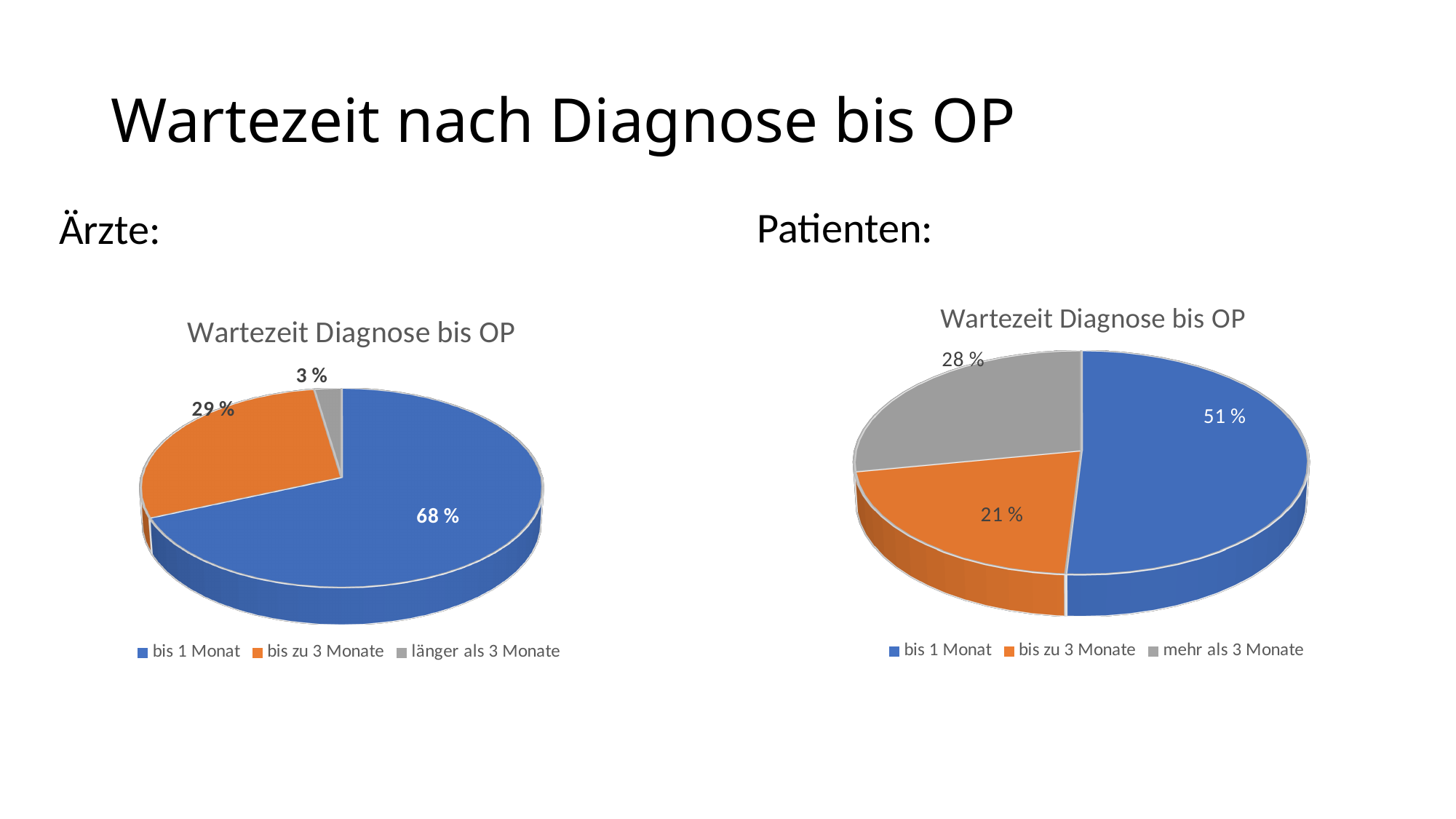
In the Ärzte pie chart on the left, what is the value for 'bis zu 3 Monate'? 29 % In the Patienten pie chart on the right, which category has the smallest share? bis zu 3 Monate Which chart shows a larger value for 'bis 1 Monat', the Ärzte chart on the left or the Patienten chart on the right? Ärzte chart on the left In the Ärzte pie chart on the left, what is the value for 'bis 1 Monat'? 68 % In the Patienten pie chart on the right, what is the value for 'mehr als 3 Monate'? 28 % In the Ärzte pie chart on the left, which category has the largest share? bis 1 Monat What kind of chart is the Ärzte chart on the left? Pie chart In the Patienten pie chart on the right, what is the value for 'bis 1 Monat'? 51 % In the Ärzte pie chart on the left, what is the value for 'länger als 3 Monate'? 3 % In the Patienten pie chart on the right, what is the difference between 'mehr als 3 Monate' and 'bis zu 3 Monate'? 7 % In the Ärzte pie chart on the left, what is the difference between 'bis 1 Monat' and 'bis zu 3 Monate'? 39 % How many slices does the Patienten pie chart on the right have? 3